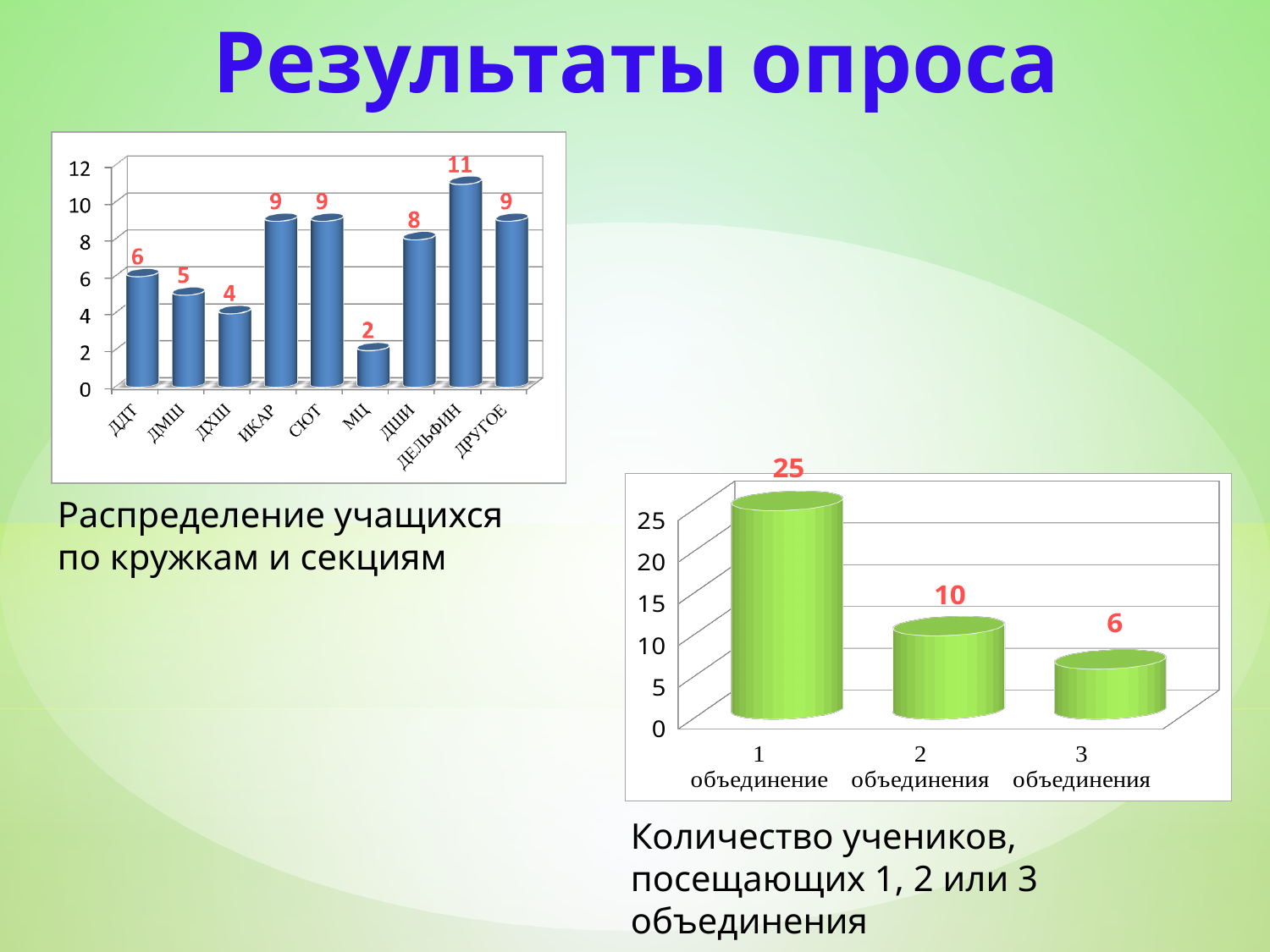
In the left chart (Распределение учащихся по кружкам и секциям), what is the value for МЦ? 2 How many bars are shown in the right chart (Количество учеников, посещающих 1, 2 или 3 объединения)? 3 What kind of chart is the left chart (Распределение учащихся по кружкам и секциям)? bar chart In the right chart (Количество учеников, посещающих 1, 2 или 3 объединения), what is the value for 1 объединение? 25 In the right chart (Количество учеников, посещающих 1, 2 или 3 объединения), what is the difference between the values for 1 объединение and 2 объединения? 15 In the right chart (Количество учеников, посещающих 1, 2 или 3 объединения), do the values rise or fall from left to right along the x axis? fall In the left chart (Распределение учащихся по кружкам и секциям), which category has the lowest value? МЦ How many categories are shown in the left chart (Распределение учащихся по кружкам и секциям)? 9 In the left chart (Распределение учащихся по кружкам и секциям), what is the value for ДЕЛЬФИН? 11 In the left chart (Распределение учащихся по кружкам и секциям), what is the difference between the values for ДЕЛЬФИН and ДШИ? 3 In the left chart (Распределение учащихся по кружкам и секциям), which category has the highest value? ДЕЛЬФИН In the left chart (Распределение учащихся по кружкам и секциям), which is larger, the value for ДДТ or the value for ДХШ? ДДТ